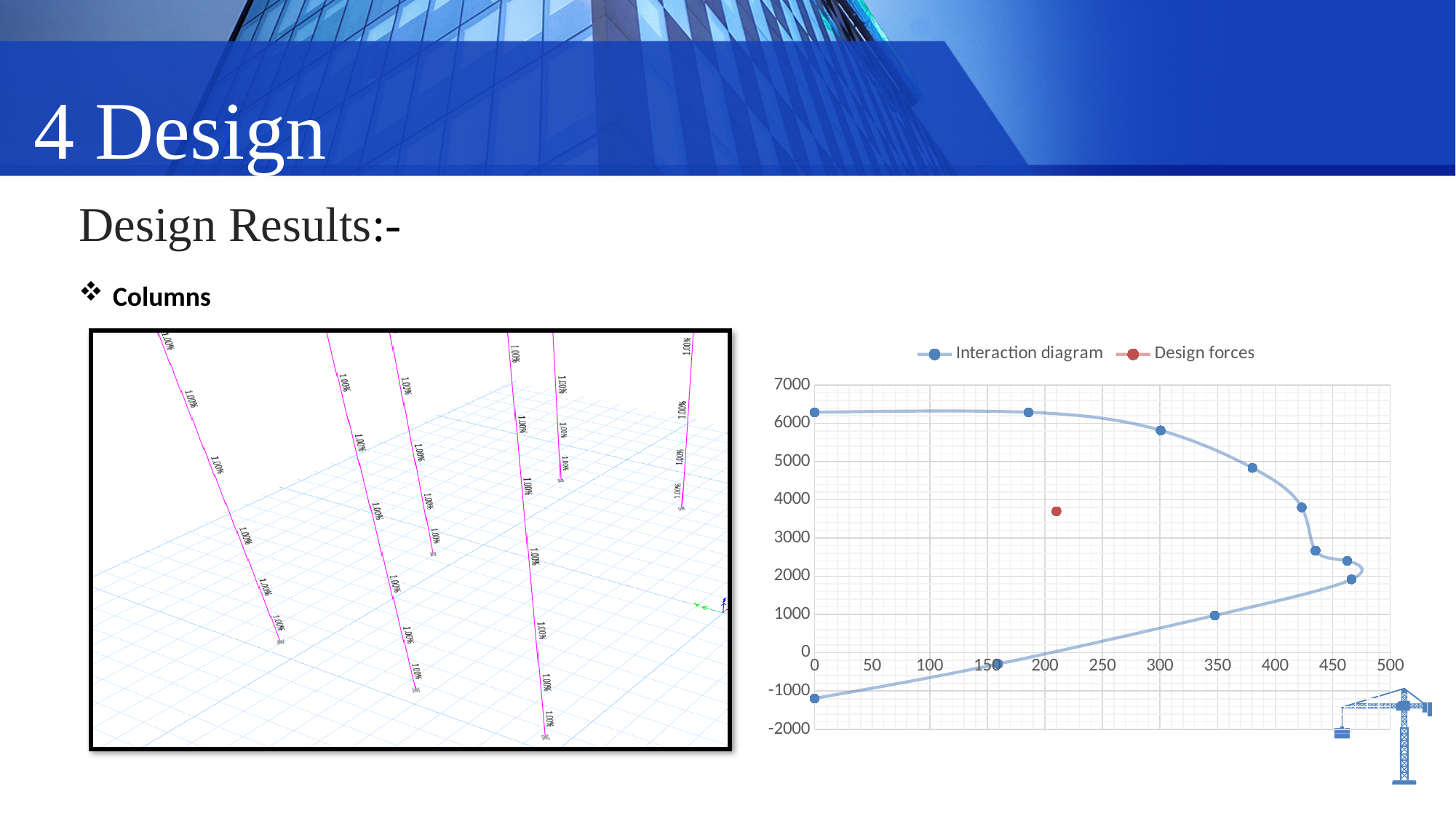
Is the largest horizontal value reached by the Interaction diagram curve greater or less than 450? greater How many points are plotted for the Design forces series? 1 What kind of chart is shown on the right of the slide? scatter chart Does the Design forces point lie inside or outside the Interaction diagram curve? inside Is the lowest vertical value on the Interaction diagram curve greater or less than -1000? less Is the vertical value of the Design forces point greater or less than 4000? less How many series does the legend of the chart list? 2 Which series is drawn with a red marker? Design forces What are the two series named in the chart legend? Interaction diagram and Design forces